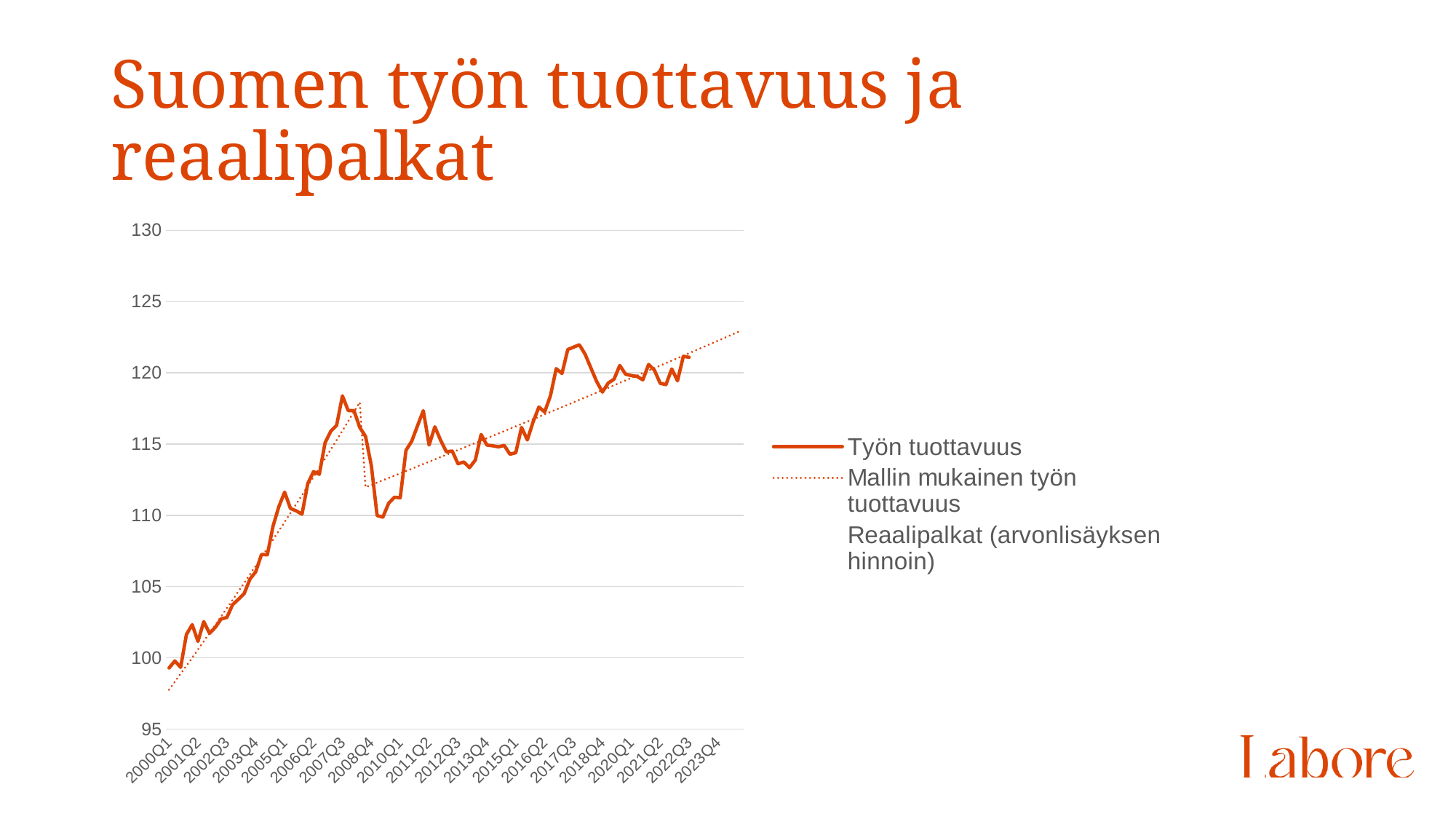
Is the value of Työn tuottavuus at 2007Q3 greater or less than 115? greater Is the value of Mallin mukainen työn tuottavuus at 2000Q1 greater or less than 100? less What kind of chart is shown on the slide? line chart Is the value of Työn tuottavuus at 2002Q3 greater or less than 105? less How many series does the legend list? 3 How many labels are shown on the x axis? 20 Which legend entry is drawn as a dotted line? Mallin mukainen työn tuottavuus Overall, does the Työn tuottavuus line rise or fall from 2000Q1 to 2022Q3? rise What is the title of the slide? Suomen työn tuottavuus ja reaalipalkat